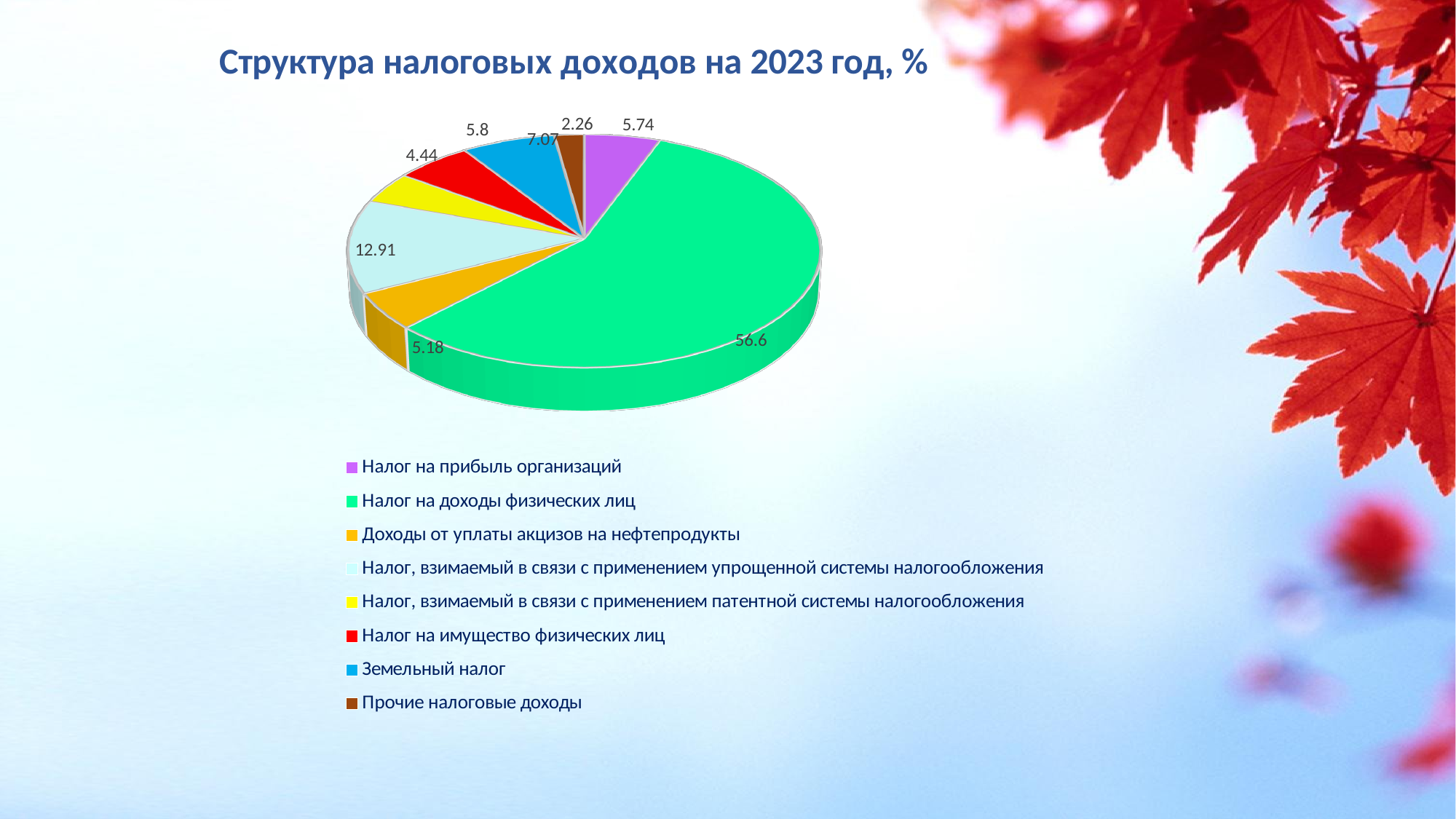
What is the value for Земельный налог? 7.07 How many categories does the legend list? 8 What is the value for Налог на доходы физических лиц? 56.6 What is the difference between the values for Налог на доходы физических лиц and Налог, взимаемый в связи с применением упрощенной системы налогообложения? 43.69 Which is larger: the value for Земельный налог or the value for Налог на имущество физических лиц? Земельный налог What is the title of the chart? Структура налоговых доходов на 2023 год, % What is the value for Налог, взимаемый в связи с применением упрощенной системы налогообложения? 12.91 What is the value for Налог на прибыль организаций? 5.74 Which category has the largest share of the pie? Налог на доходы физических лиц What is the value for Прочие налоговые доходы? 2.26 Which category has the smallest share of the pie? Прочие налоговые доходы What type of chart is shown on the slide? pie chart